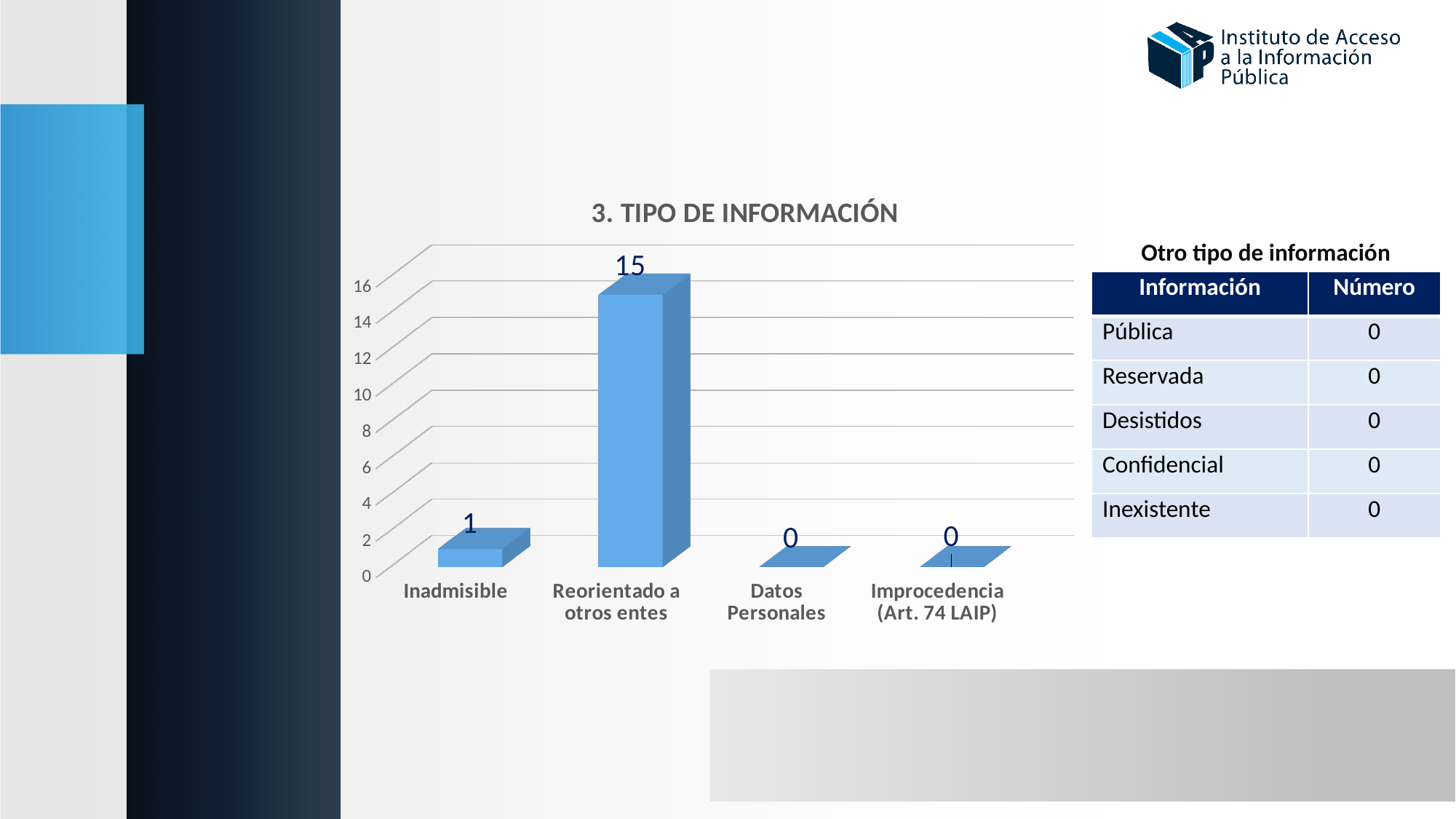
Which is larger, Inadmisible or Datos Personales? Inadmisible What is the difference between Reorientado a otros entes and Inadmisible? 14 What is the title of the chart? 3. TIPO DE INFORMACIÓN What is the highest value shown on the vertical axis of the chart? 16 Which category has the highest value? Reorientado a otros entes What is the value for Improcedencia (Art. 74 LAIP)? 0 How many categories are shown on the x axis of the chart? 4 What kind of chart is shown on the slide? bar chart What is the value for Datos Personales? 0 Is the value for Reorientado a otros entes greater or less than 10? greater What is the value for Inadmisible in the chart? 1 What is the value for Reorientado a otros entes? 15